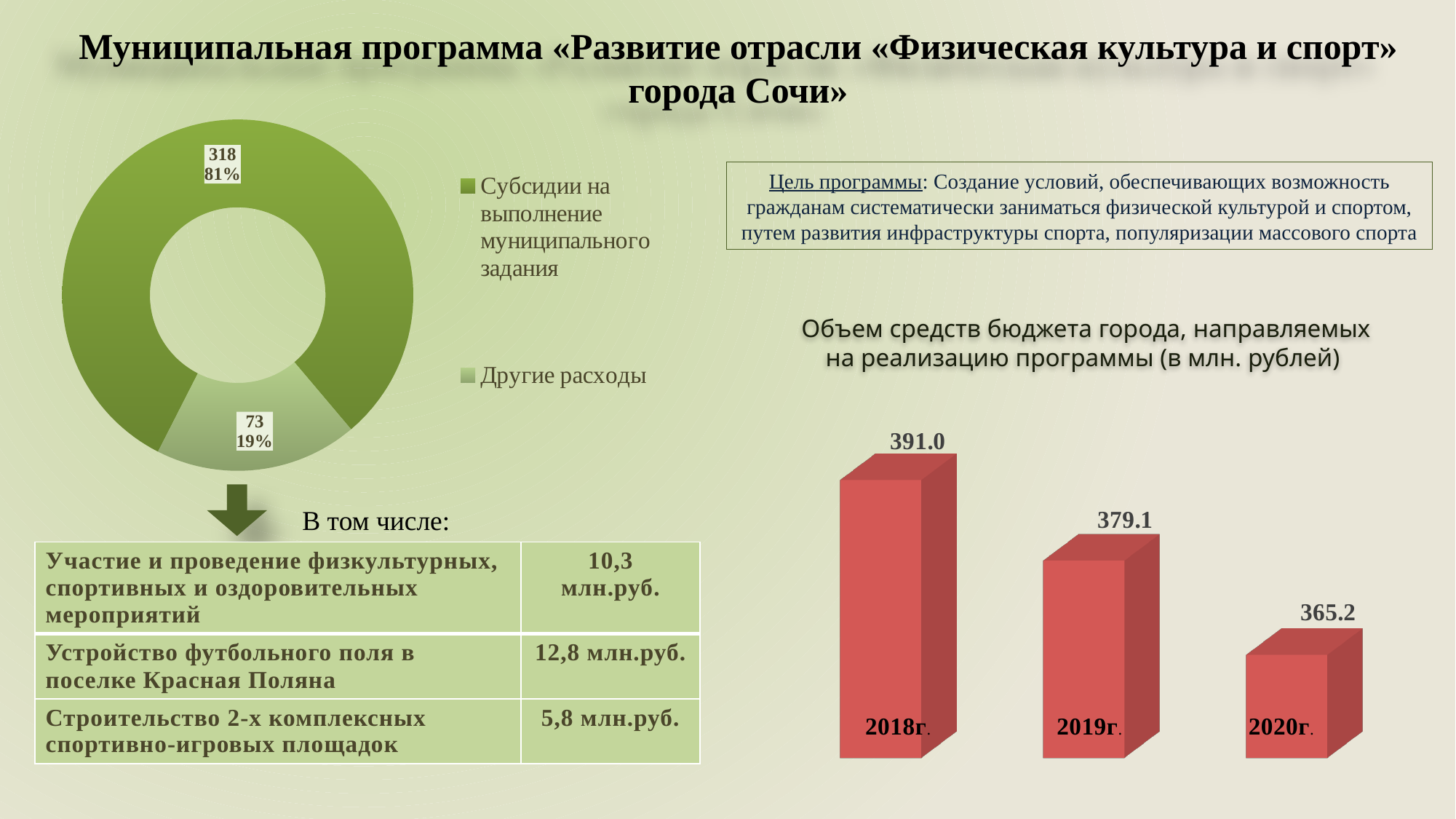
In the bar chart on the right, what is the value for 2018г.? 391.0 In the donut chart on the left, what share does Другие расходы have? 19% In the bar chart on the right, which year has the lowest value? 2020г. In the bar chart on the right, do the values rise or fall from 2018г. to 2020г.? fall In the bar chart on the right, what is the difference between the values for 2018г. and 2019г.? 11.9 What kind of chart is the chart on the right of the slide? bar chart In the donut chart on the left, what is the value for Субсидии на выполнение муниципального задания? 318 In the donut chart on the left, which is larger: Субсидии на выполнение муниципального задания or Другие расходы? Субсидии на выполнение муниципального задания How many bars are in the bar chart on the right? 3 How many entries does the legend of the donut chart on the left list? 2 In the bar chart on the right, what is the value for 2020г.? 365.2 In the bar chart on the right, which year has the highest value? 2018г.